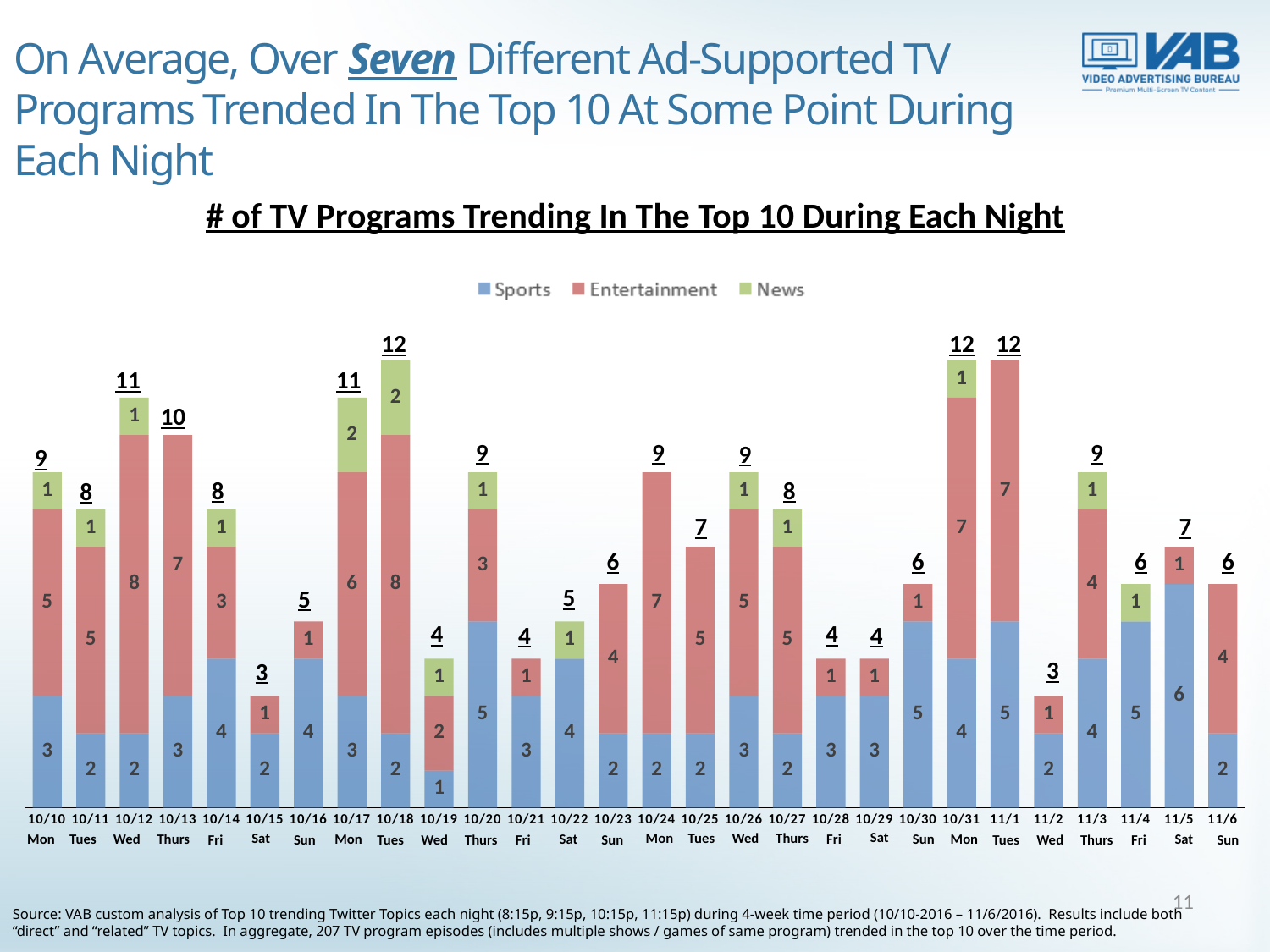
What is the News value for 10/17 (Mon)? 2 What is the Sports value for 10/20 (Thurs)? 5 What is the title of the chart? # of TV Programs Trending In The Top 10 During Each Night What is the total number of TV programs trending on 10/18 (Tues)? 12 Which date has the highest Sports value? 11/5 (Sat) Which is larger, the total for 10/13 (Thurs) or the total for 10/14 (Fri)? 10/13 (Thurs) What type of chart is shown on the slide? Stacked bar chart How many dates (bars) are shown on the x axis? 28 What are the three series named in the legend? Sports, Entertainment, News What is the Entertainment value for 10/24 (Mon)? 7 How many series does the legend list? 3 What is the difference between the total for 10/31 (Mon) and the total for 11/2 (Wed)? 9